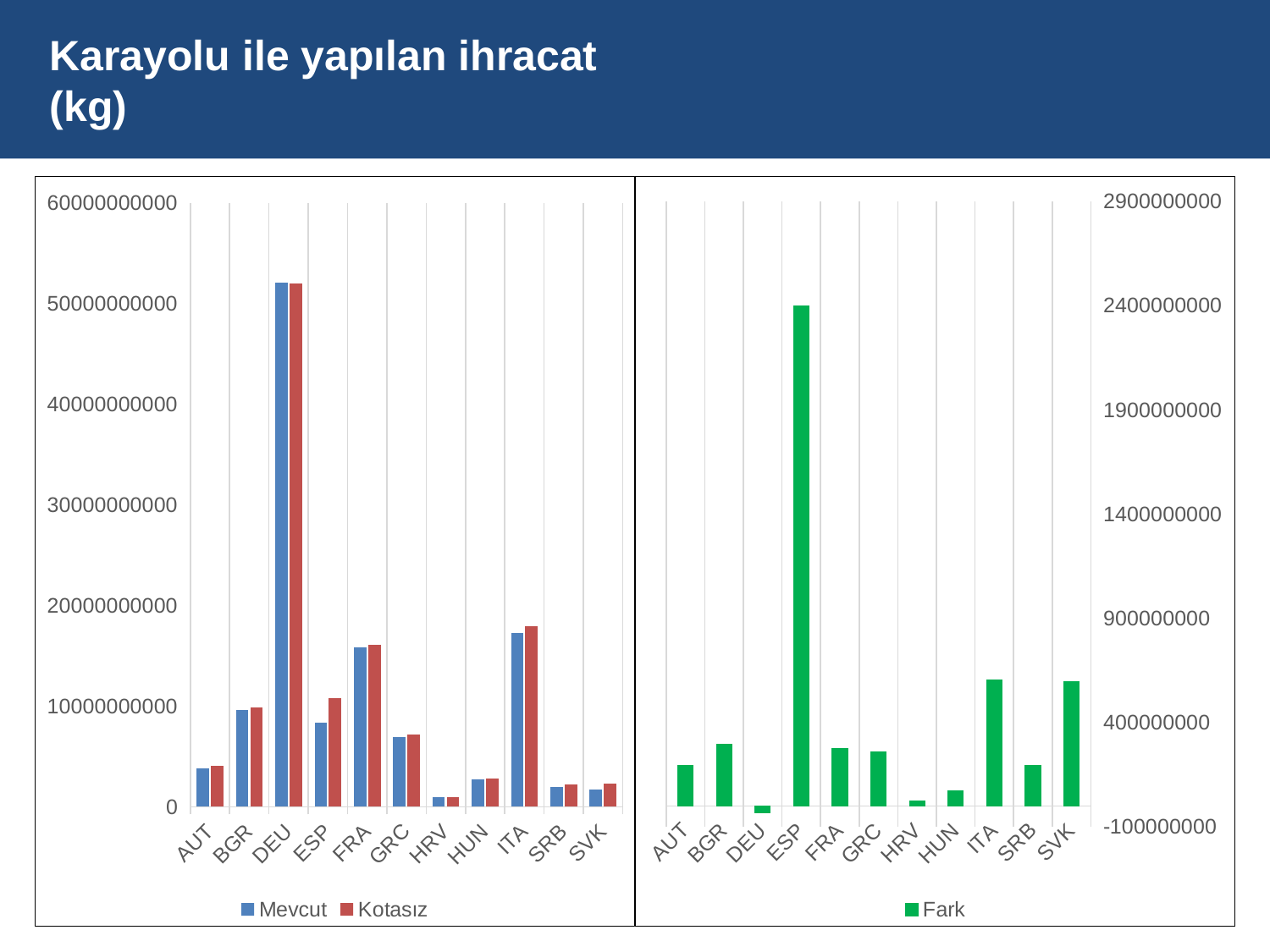
In the left chart, is the Kotasız value for ITA greater or less than 20000000000? less What are the series names in the legend of the left chart? Mevcut and Kotasız In the left chart, which category has the lowest Kotasız value? HRV In the right chart (Fark), which category has the lowest value? DEU How many series does the legend of the left chart list? 2 How many categories are shown on the x axis of the right chart (Fark)? 11 What kind of chart is the left chart on the slide? bar chart In the right chart (Fark), which category has the highest value? ESP In the left chart, is the Mevcut value for DEU greater or less than 40000000000? greater In the left chart, which is larger for ESP: the Mevcut value or the Kotasız value? Kotasız In the right chart (Fark), is the value for ESP greater or less than 1900000000? greater In the left chart, which category has the highest Mevcut value? DEU